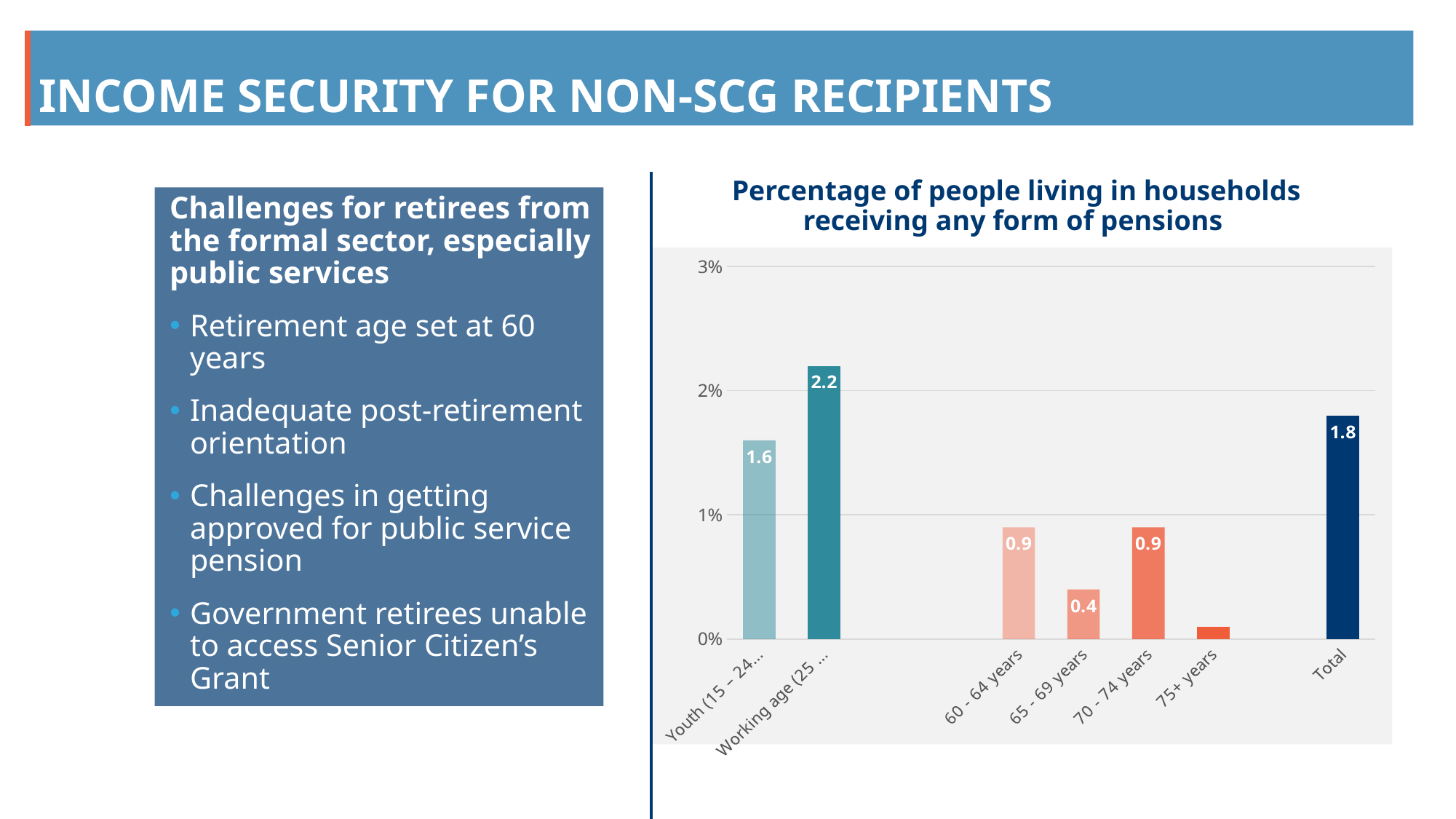
What is the value for the Working age group in the chart? 2.2 How many bars are plotted in the chart? 7 Which category has the lowest value in the chart? 75+ years What type of chart is shown on the slide? bar chart What is the value for the 65 - 69 years group? 0.4 Is the value for 75+ years greater or less than 1%? less What is the difference between the Working age value and the Youth value? 0.6 What is the value for the Youth group? 1.6 What is the value shown for Total? 1.8 What is the difference between the 60 - 64 years value and the 65 - 69 years value? 0.5 Which category has the highest value in the chart? Working age Which is larger, the value for Youth or the value for Total? Total